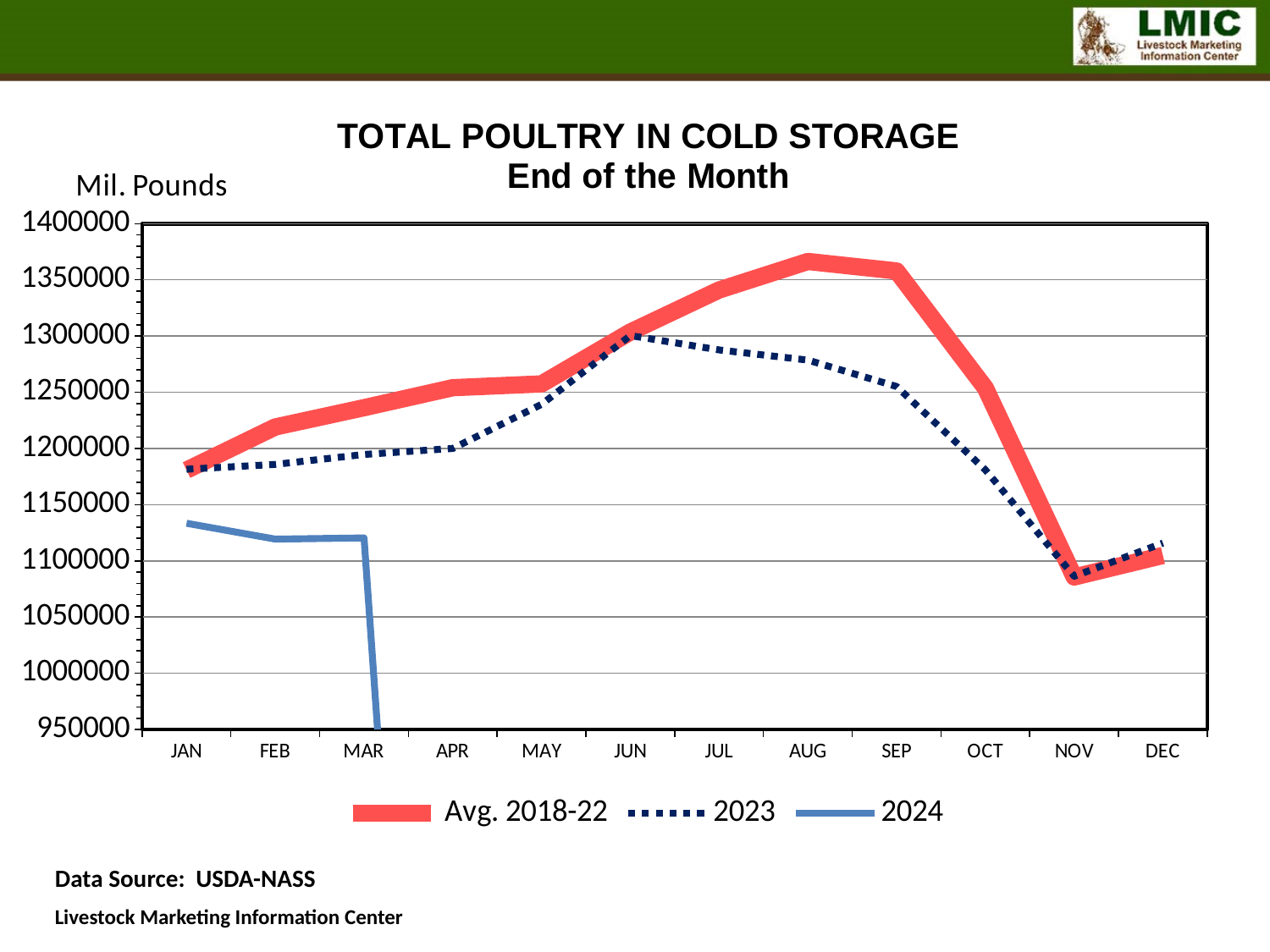
How many series does the legend list? 3 In AUG, which series has the larger value, Avg. 2018-22 or 2023? Avg. 2018-22 Is the 2024 value for JAN greater or less than 1150000? less Is the Avg. 2018-22 value for AUG greater or less than 1350000? greater Is the 2023 value for NOV greater or less than 1100000? less In which month does the Avg. 2018-22 series reach its highest value? AUG What unit is shown on the y axis label? Mil. Pounds In which month does the Avg. 2018-22 series reach its lowest value? NOV How many months are shown along the x axis? 12 What kind of chart is shown on the slide? line chart In which month does the 2023 series reach its lowest value? NOV Does the Avg. 2018-22 series rise or fall from JAN to AUG? rise